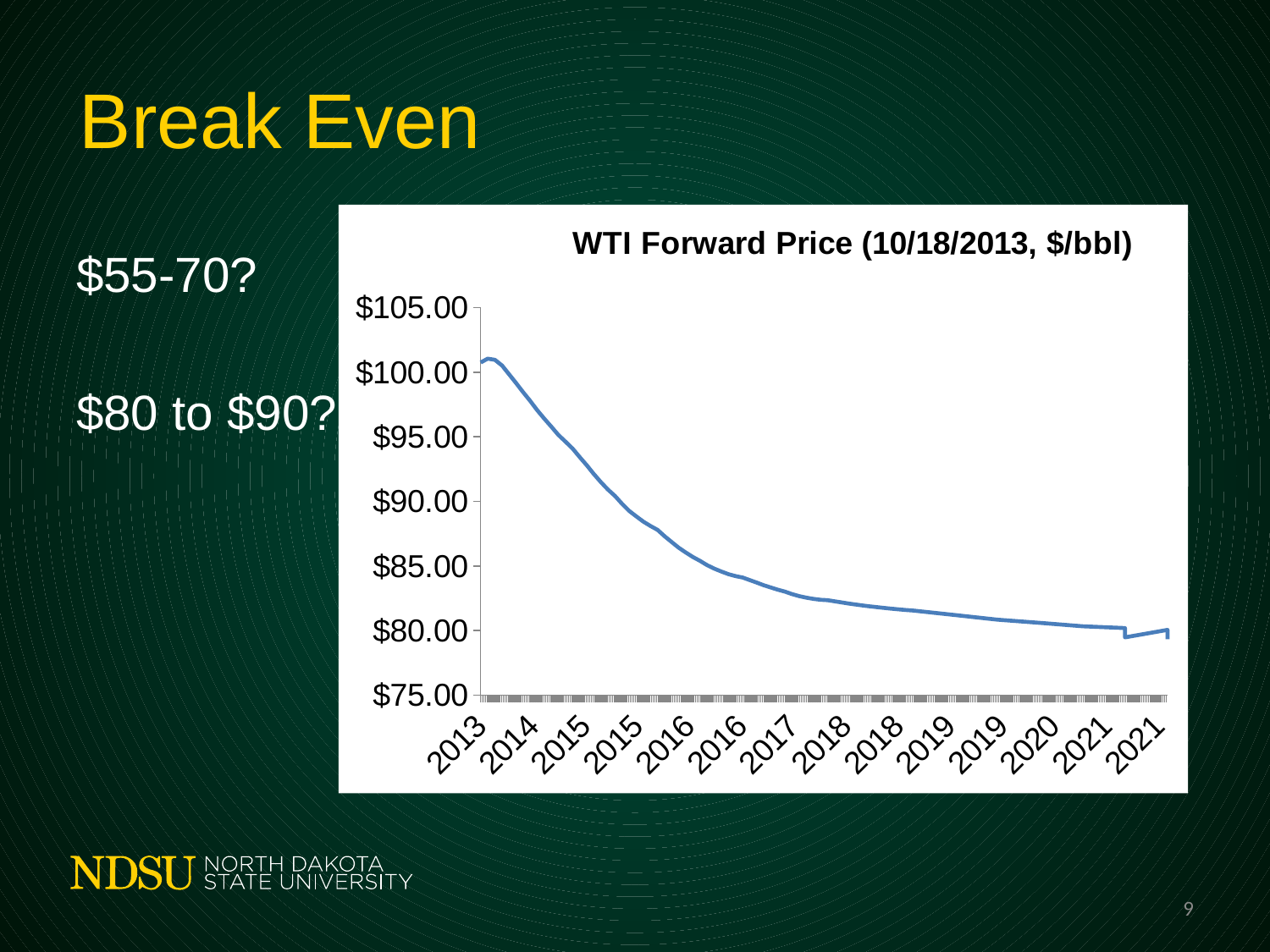
Is the value at the end of the line in 2021 greater or less than $85.00? less What is the title of the chart? WTI Forward Price (10/18/2013, $/bbl) How many lines (series) are plotted in the chart? 1 What kind of chart is shown on the slide? line chart What is the highest tick value shown on the y axis? $105.00 Is the value at the start of the line in 2013 greater or less than $95.00? greater Do the values in the chart rise or fall as you move from 2013 to 2021 along the x axis? fall Is the value for 2015 greater or less than $85.00? greater In which year does the line reach its lowest value? 2021 Which is larger, the value for 2014 or the value for 2020? 2014 In which year does the line reach its highest value? 2013